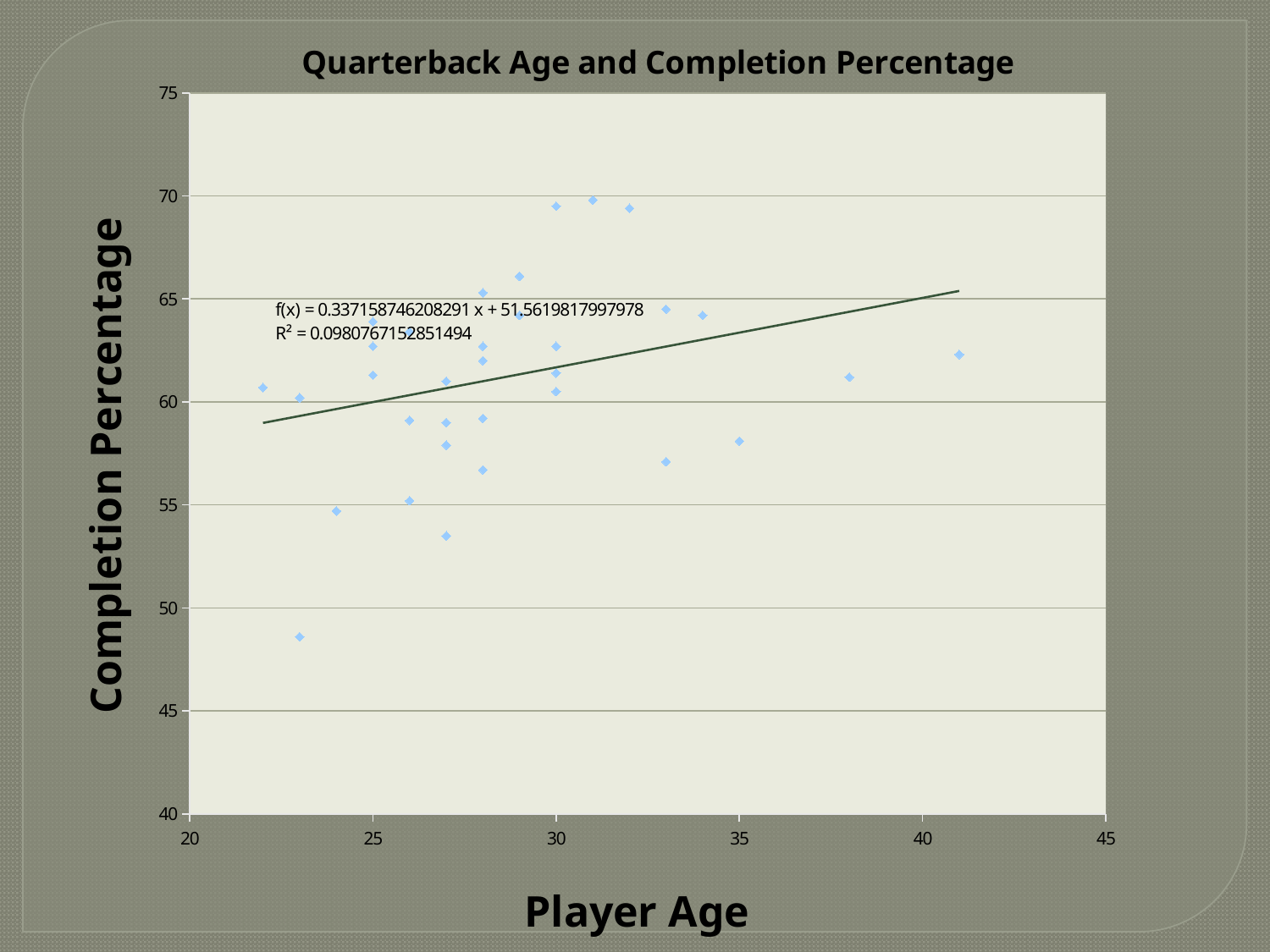
Does the trendline rise or fall as player age increases? Rises Is the completion percentage for the player aged 38 greater or less than 60? greater Is the completion percentage for the player aged 35 greater or less than 60? less What is the title of the chart? Quarterback Age and Completion Percentage At what player age is the lowest completion percentage point plotted? 23 Which has the higher completion percentage: the player aged 41 or the player aged 35? The player aged 41 Is the lowest plotted completion percentage greater or less than 50? less What kind of chart is shown on the slide? Scatter chart What R² value is printed on the chart? R² = 0.0980767152851494